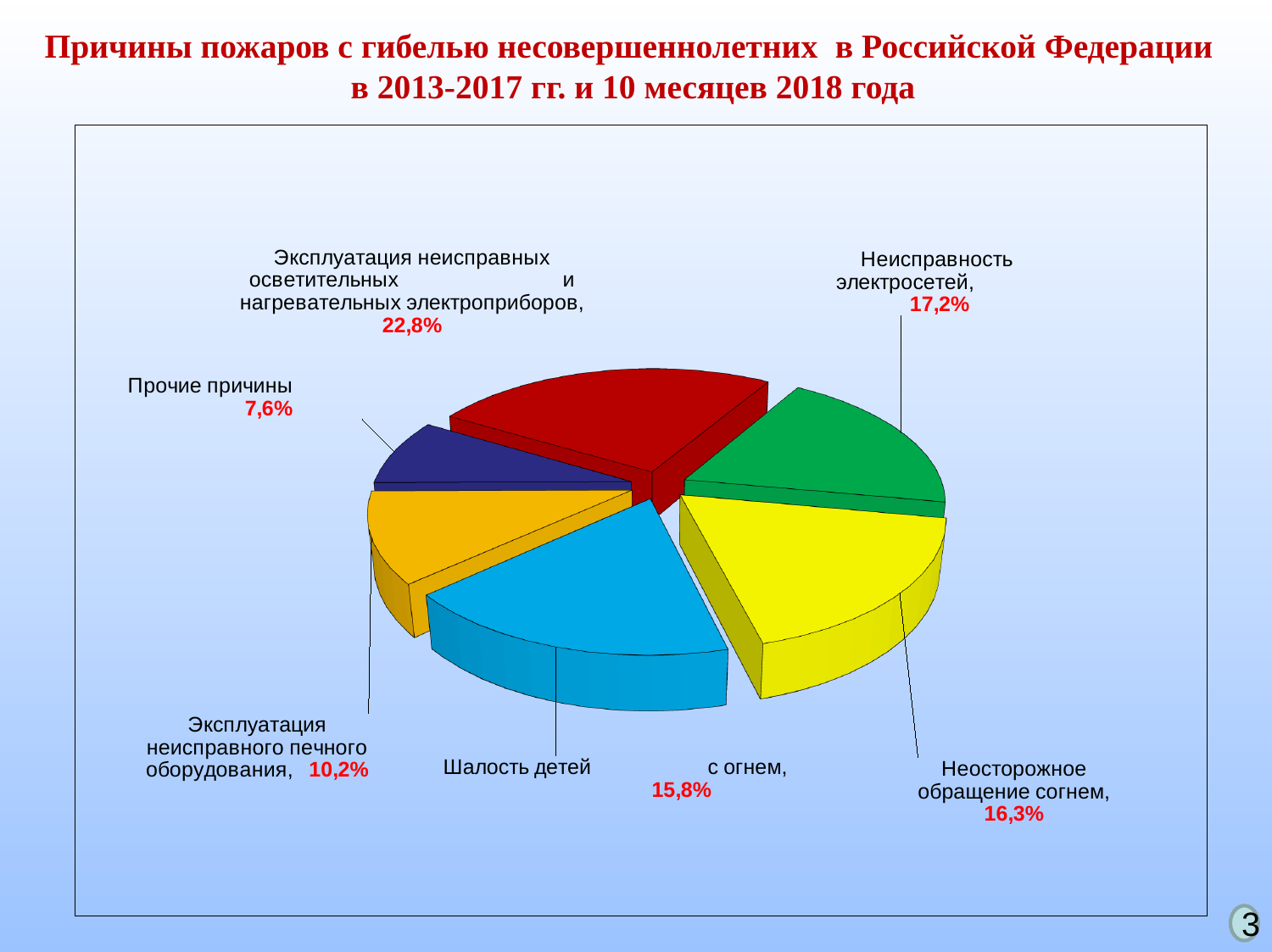
What is the difference in percentage points between «Эксплуатация неисправных осветительных и нагревательных электроприборов» and «Неисправность электросетей»? 5,6 Which cause has the smallest share in the pie chart? Прочие причины What percentage is shown for «Шалость детей с огнем»? 15,8% How many slices does the pie chart have? 6 What colour is the slice for «Неисправность электросетей»? Green Which cause has the largest share in the pie chart? Эксплуатация неисправных осветительных и нагревательных электроприборов What percentage is shown for «Эксплуатация неисправного печного оборудования»? 10,2% What kind of chart is shown on the slide? Pie chart What percentage is shown for «Неосторожное обращение с огнем»? 16,3% What percentage is shown for «Прочие причины»? 7,6% What percentage is shown for «Неисправность электросетей»? 17,2% Which is larger: the share for «Неосторожное обращение с огнем» or the share for «Шалость детей с огнем»? Неосторожное обращение с огнем